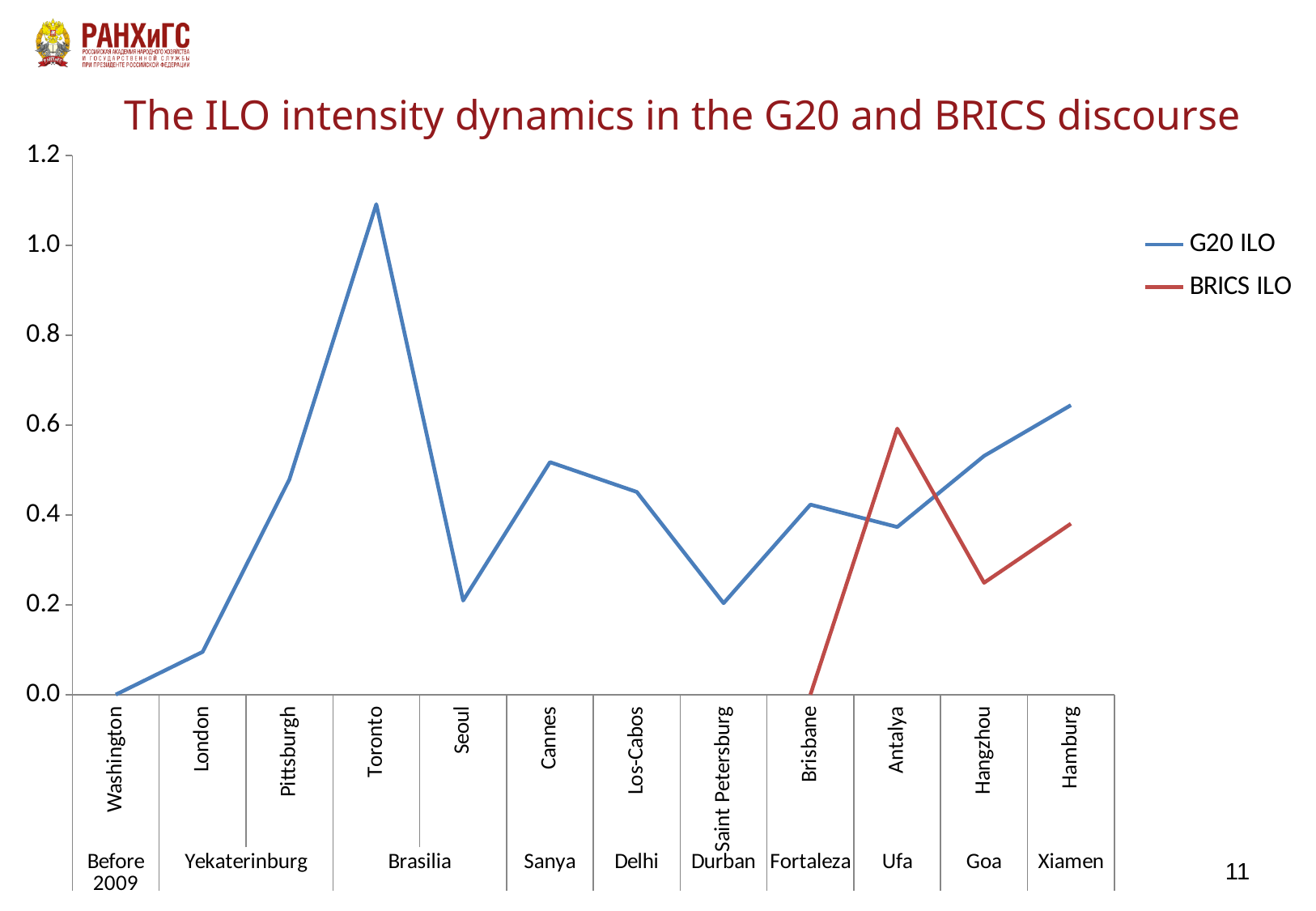
Is the BRICS ILO value at Goa greater or less than 0.4? less At which summit does the G20 ILO series reach its highest value? Toronto How many G20 summit labels are shown along the x axis? 12 At Antalya, which series has the larger value, G20 ILO or BRICS ILO? BRICS ILO What are the two series named in the legend? G20 ILO and BRICS ILO How many series does the legend list? 2 Is the G20 ILO value at Toronto greater or less than 1.0? greater At Hangzhou, which series has the larger value, G20 ILO or BRICS ILO? G20 ILO Does the G20 ILO series rise or fall from Washington to Toronto? rise Is the G20 ILO value at Seoul greater or less than 0.4? less At which summit does the BRICS ILO series reach its highest value? Ufa What kind of chart is shown on the slide? line chart